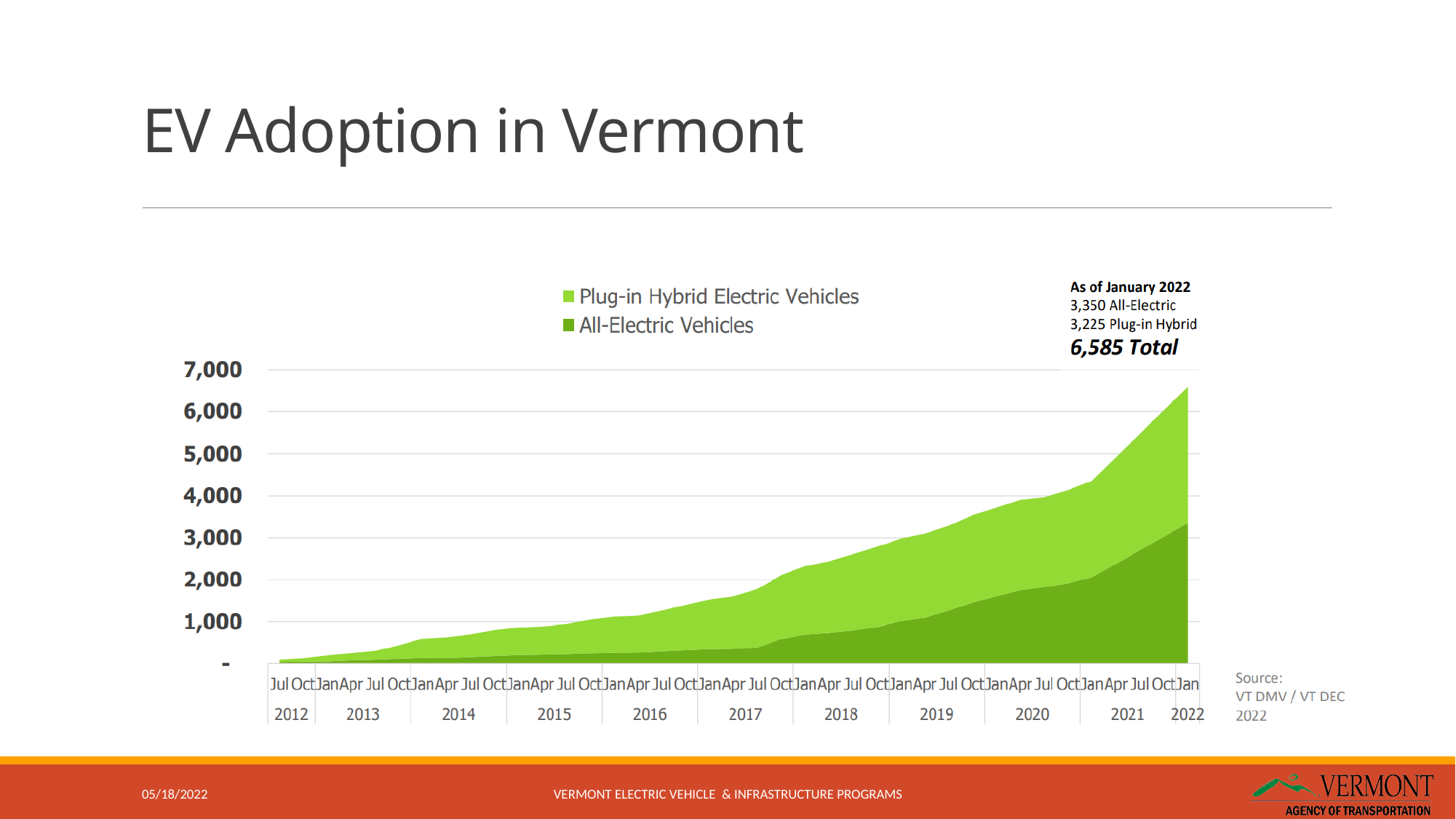
How many years are labeled along the x axis? 11 What are the two series named in the legend? Plug-in Hybrid Electric Vehicles and All-Electric Vehicles As of January 2022, how many All-Electric vehicles are reported? 3,350 Is the total EV value at January 2020 greater or less than 3,000? greater Is the total EV value at January 2017 greater or less than 3,000? less As of January 2022, how many Plug-in Hybrid vehicles are reported? 3,225 Do the total EV values rise or fall from 2012 to 2022? Rise What is the total number of EVs as of January 2022? 6,585 Total What kind of chart is shown on the slide? Stacked area chart As of January 2022, what is the difference between the number of All-Electric and Plug-in Hybrid vehicles? 125 As of January 2022, which is larger: All-Electric vehicles or Plug-in Hybrid vehicles? All-Electric How many series does the chart's legend list? 2